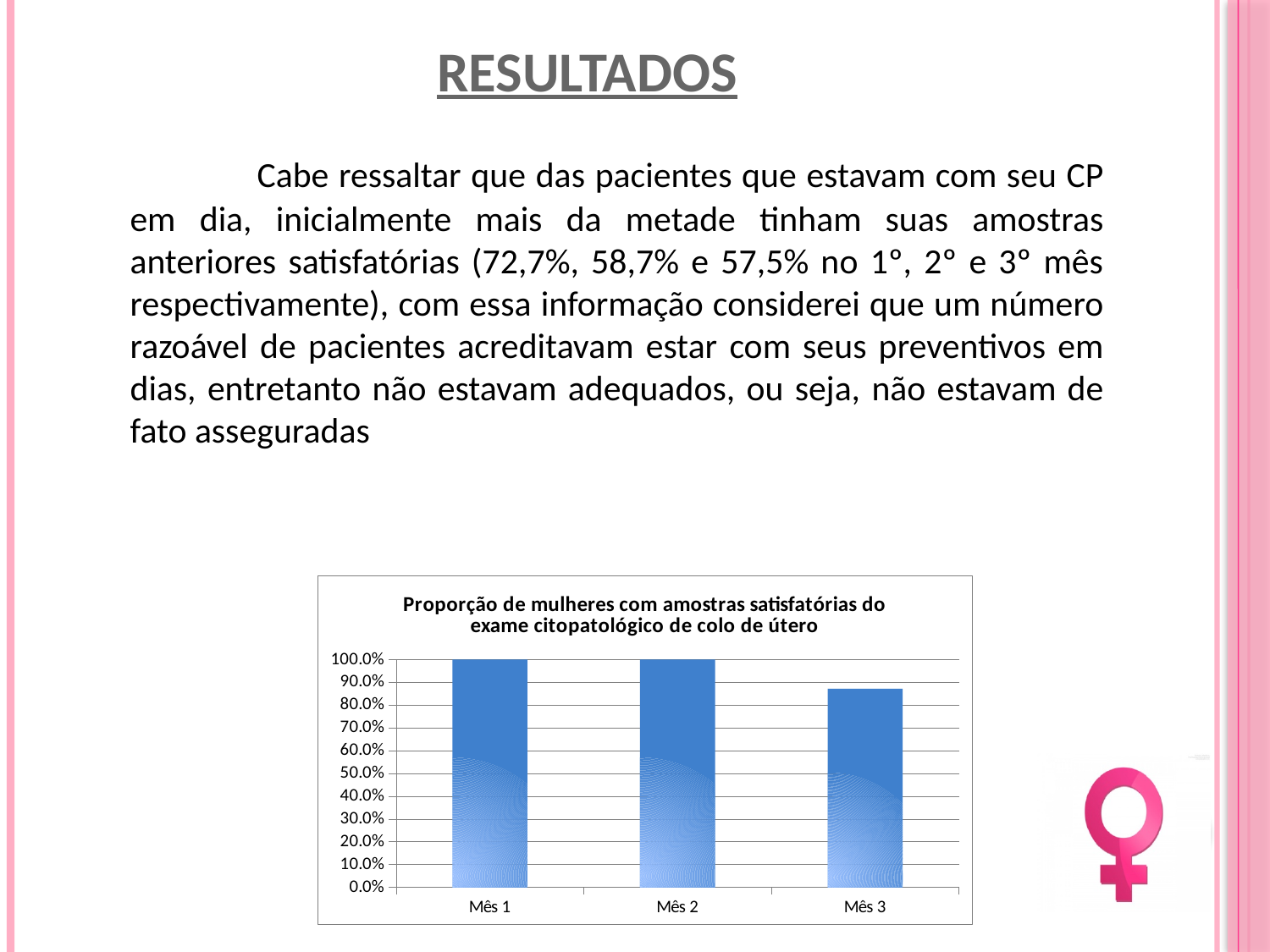
Which is larger, the value for Mês 1 or the value for Mês 3? Mês 1 Is the value for Mês 3 greater or less than 80.0%? greater What kind of chart is shown on the slide? bar chart Do the values rise or fall from Mês 2 to Mês 3? fall What is the title of the chart? Proporção de mulheres com amostras satisfatórias do exame citopatológico de colo de útero What is the value for Mês 1 in the chart? 100.0% What colour are the bars in the chart? blue Which category has the lowest value in the chart? Mês 3 How many categories are plotted on the x axis of the chart? 3 Is the value for Mês 3 greater or less than 90.0%? less What is the value for Mês 2 in the chart? 100.0% Which is larger, the value for Mês 2 or the value for Mês 3? Mês 2